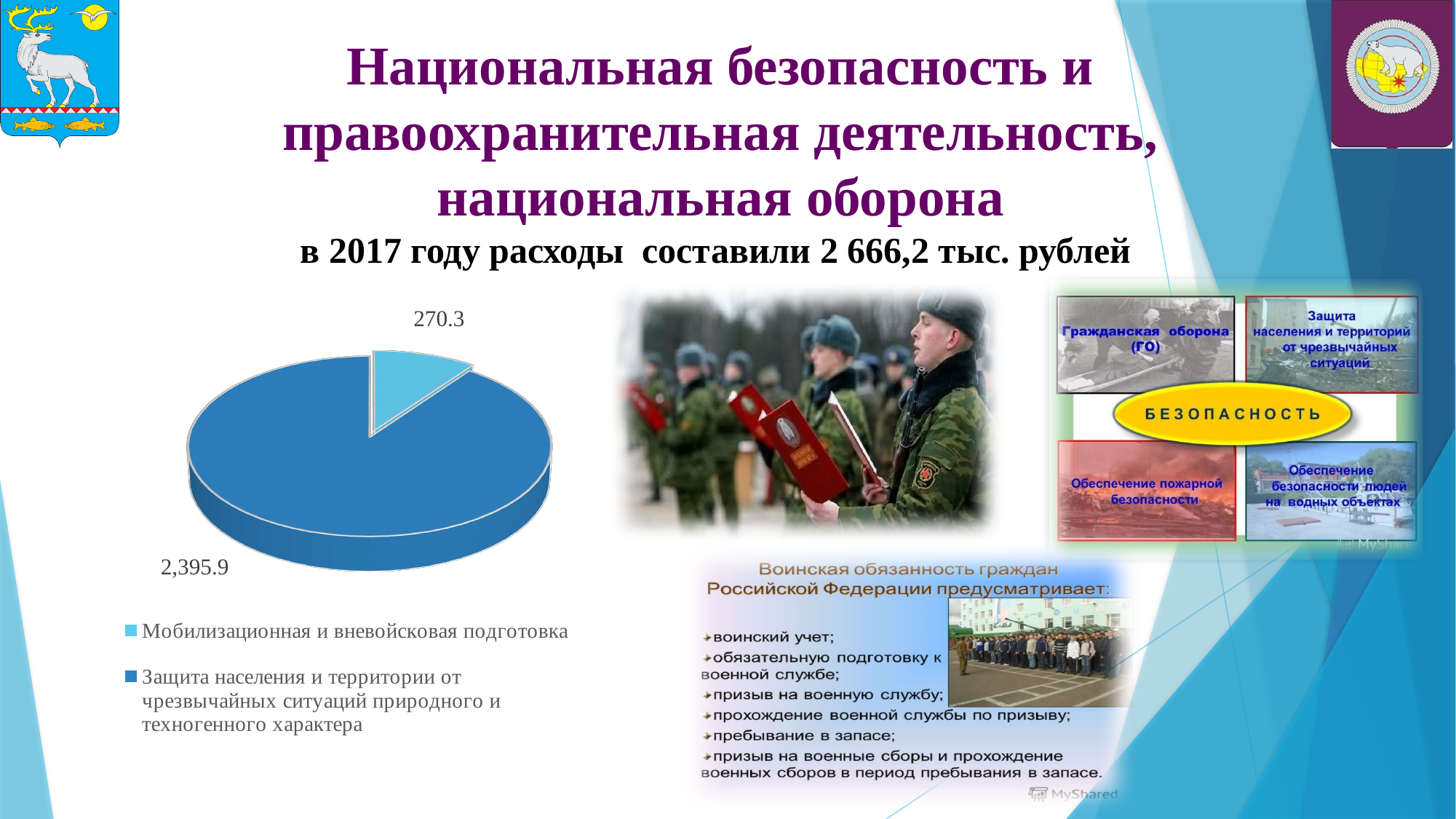
Which category has the largest slice in the pie chart? Защита населения и территории от чрезвычайных ситуаций природного и техногенного характера How many entries does the legend of the pie chart list? 2 What is the value for Защита населения и территории от чрезвычайных ситуаций природного и техногенного характера in the pie chart? 2,395.9 How many slices does the pie chart have? 2 What is the difference between the two values shown in the pie chart? 2,125.6 What colour is the slice for Мобилизационная и вневойсковая подготовка? light blue Which is larger: the value for Мобилизационная и вневойсковая подготовка or the value for Защита населения и территории от чрезвычайных ситуаций? Защита населения и территории от чрезвычайных ситуаций What is the value for Мобилизационная и вневойсковая подготовка in the pie chart? 270.3 What type of chart is shown on the slide? pie chart Which category has the smallest slice in the pie chart? Мобилизационная и вневойсковая подготовка What is the total of the two values shown in the pie chart? 2,666.2 According to the slide subtitle, what were the total expenditures in 2017? 2 666,2 тыс. рублей